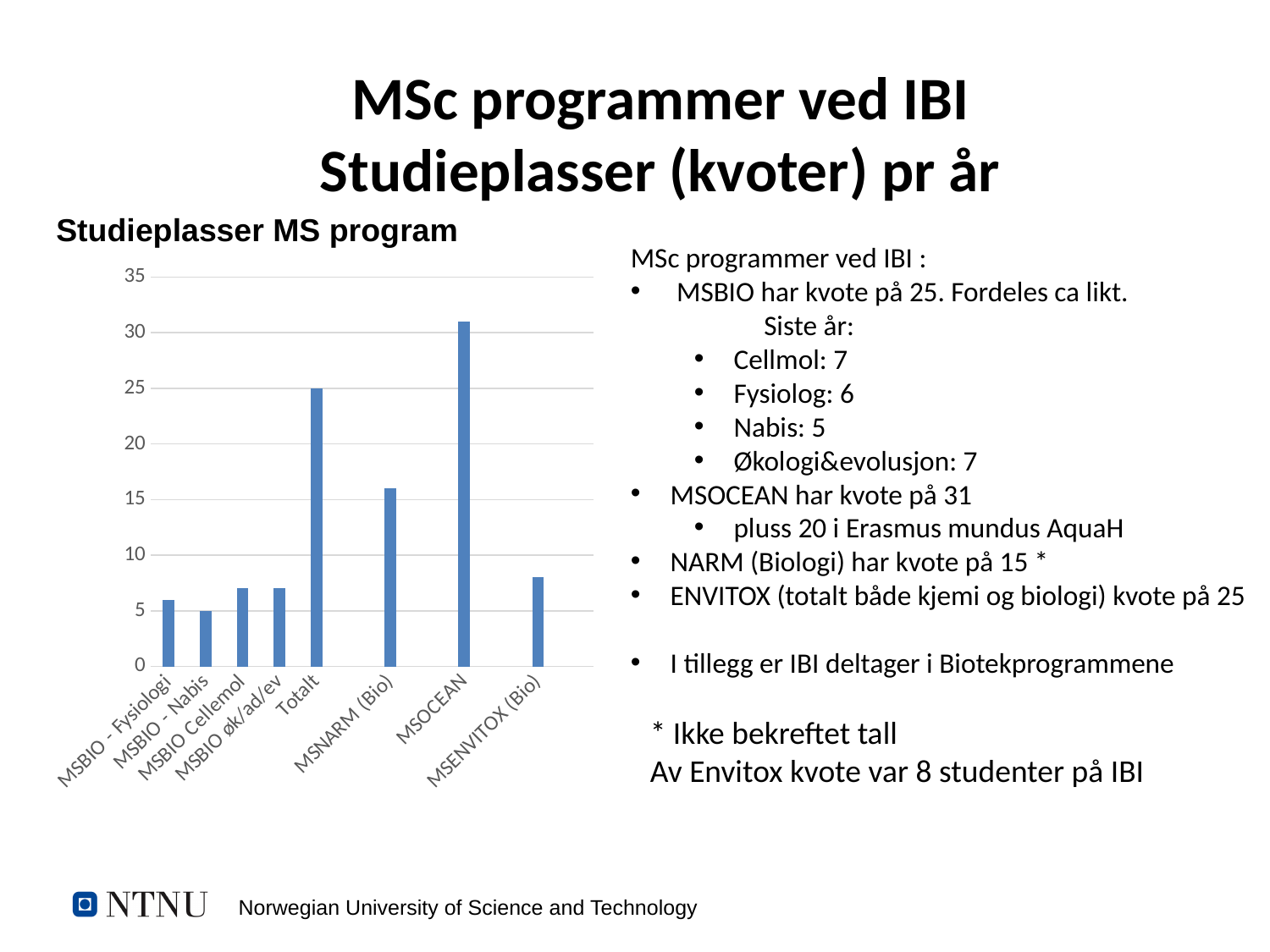
Is the value for MSNARM (Bio) greater or less than 15? greater What is the title of the chart? Studieplasser MS program Which is larger, the value for MSOCEAN or the value for Totalt? MSOCEAN What is the value for Totalt in the chart? 25 Is the value for MSOCEAN greater or less than 30? greater What kind of chart is shown on the slide? bar chart How many categories are shown on the x axis of the chart? 8 What is the value for MSBIO - Nabis in the chart? 5 Is the value for MSENVITOX (Bio) greater or less than 10? less Which category has the lowest value in the chart? MSBIO - Nabis What is the difference between the values for Totalt and MSBIO - Nabis? 20 Which category has the highest value in the chart? MSOCEAN